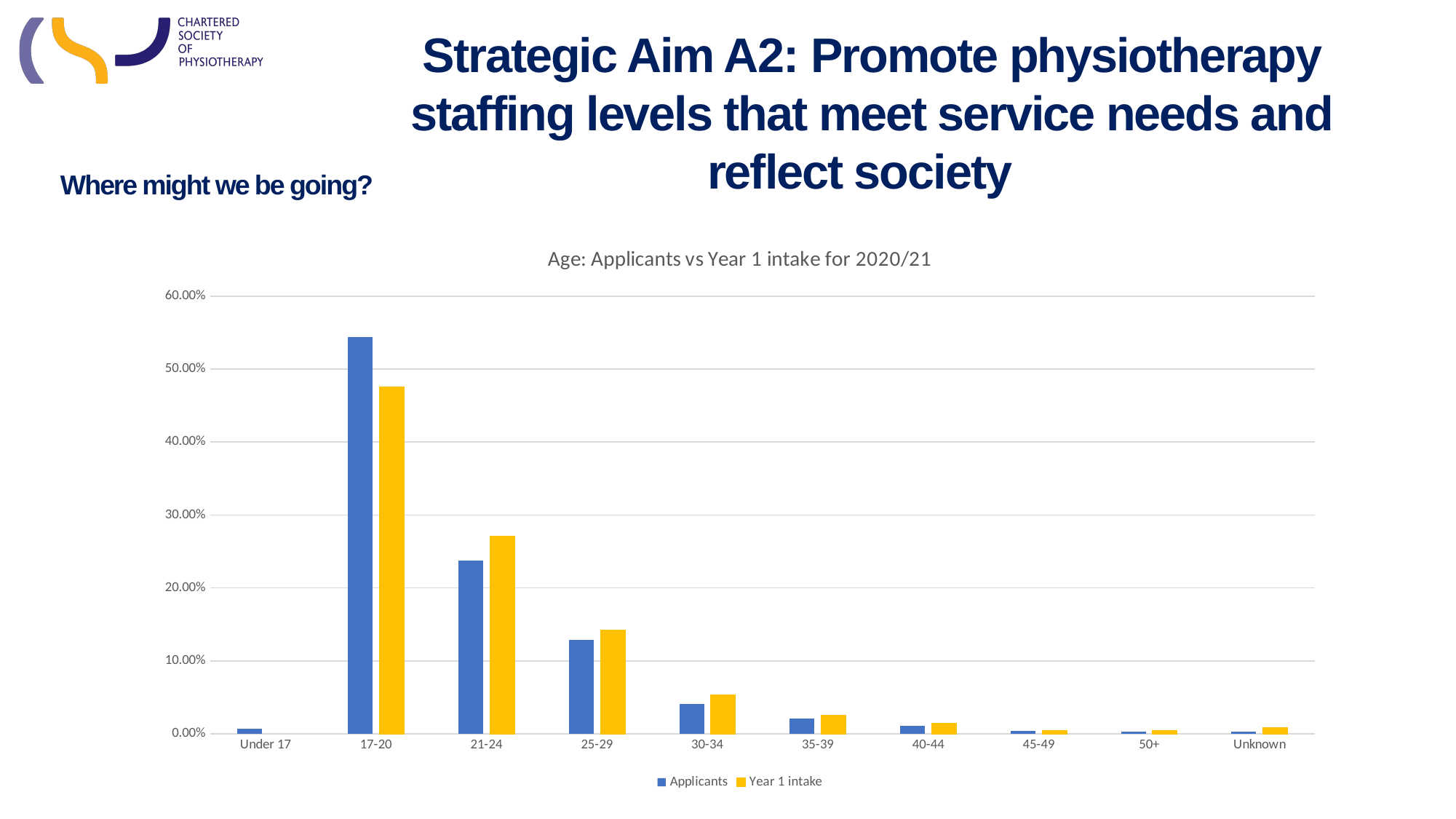
Is the Applicants value for 21-24 greater or less than 20.00%? greater What is the title of the chart? Age: Applicants vs Year 1 intake for 2020/21 What kind of chart is shown on the slide? bar chart How many age categories are shown on the x axis? 10 Which age category has the highest Year 1 intake value? 17-20 Is the Applicants value for 17-20 greater or less than 50.00%? greater Is the Year 1 intake value for 21-24 greater or less than 30.00%? less Which age category has the highest Applicants value? 17-20 For the 17-20 age group, which is larger: Applicants or Year 1 intake? Applicants For the 21-24 age group, which is larger: Applicants or Year 1 intake? Year 1 intake How many series does the legend list? 2